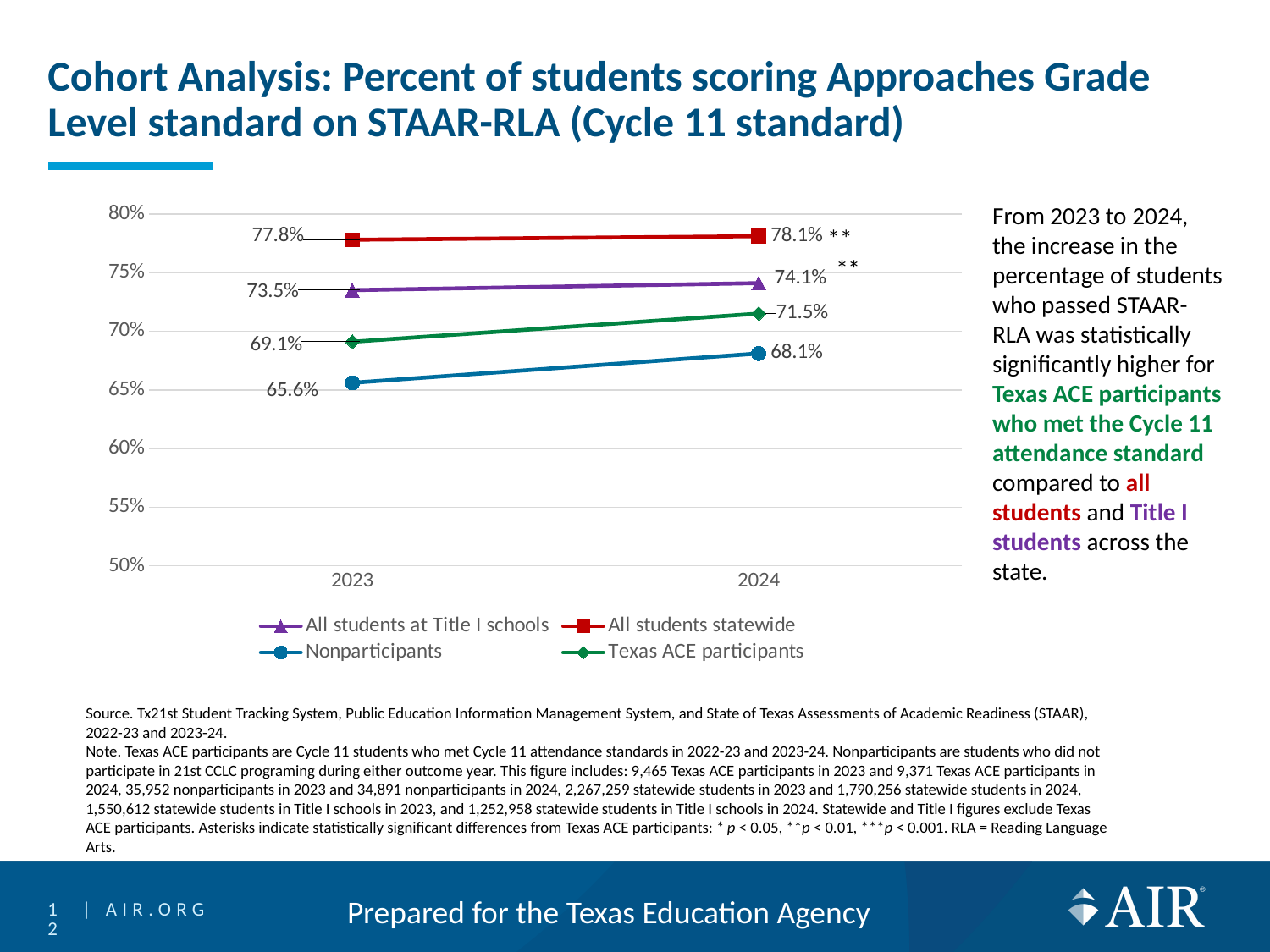
Which series had the lowest value in 2023? Nonparticipants Does the value for Nonparticipants rise or fall from 2023 to 2024? rise What was the value for All students statewide in 2023? 77.8% Which series had the highest value in 2024? All students statewide How many years are shown on the x axis? 2 Which is larger: the 2024 value for Texas ACE participants or the 2024 value for Nonparticipants? Texas ACE participants By how many percentage points did the value for Texas ACE participants change from 2023 to 2024? 2.4 percentage points What was the value for Texas ACE participants in 2024? 71.5% How many series does the legend list? 4 What was the value for Nonparticipants in 2023? 65.6% What type of chart is shown on the slide? line chart What was the value for All students at Title I schools in 2024? 74.1%